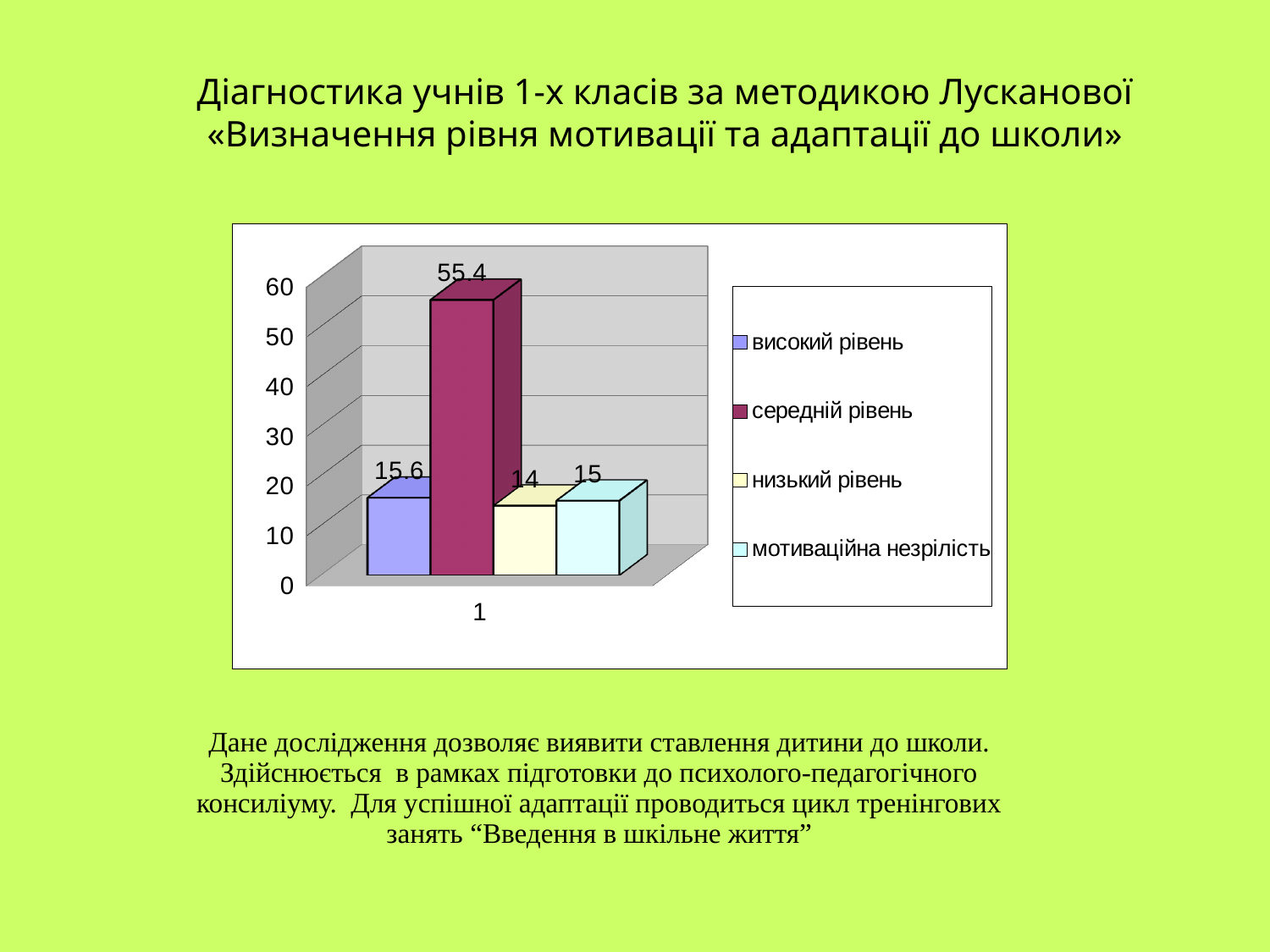
What is the difference between the values for мотиваційна незрілість and низький рівень? 1 How many series does the legend list? 4 Is the value for середній рівень greater or less than 50? greater What is the difference between the values for середній рівень and високий рівень? 39.8 Which series has the lowest value? низький рівень What kind of chart is shown on the slide? bar chart What is the value for високий рівень? 15.6 What is the value for низький рівень? 14 What is the value for середній рівень? 55.4 Which series has the highest value? середній рівень What is the value for мотиваційна незрілість? 15 Which is larger, the value for високий рівень or the value for мотиваційна незрілість? високий рівень